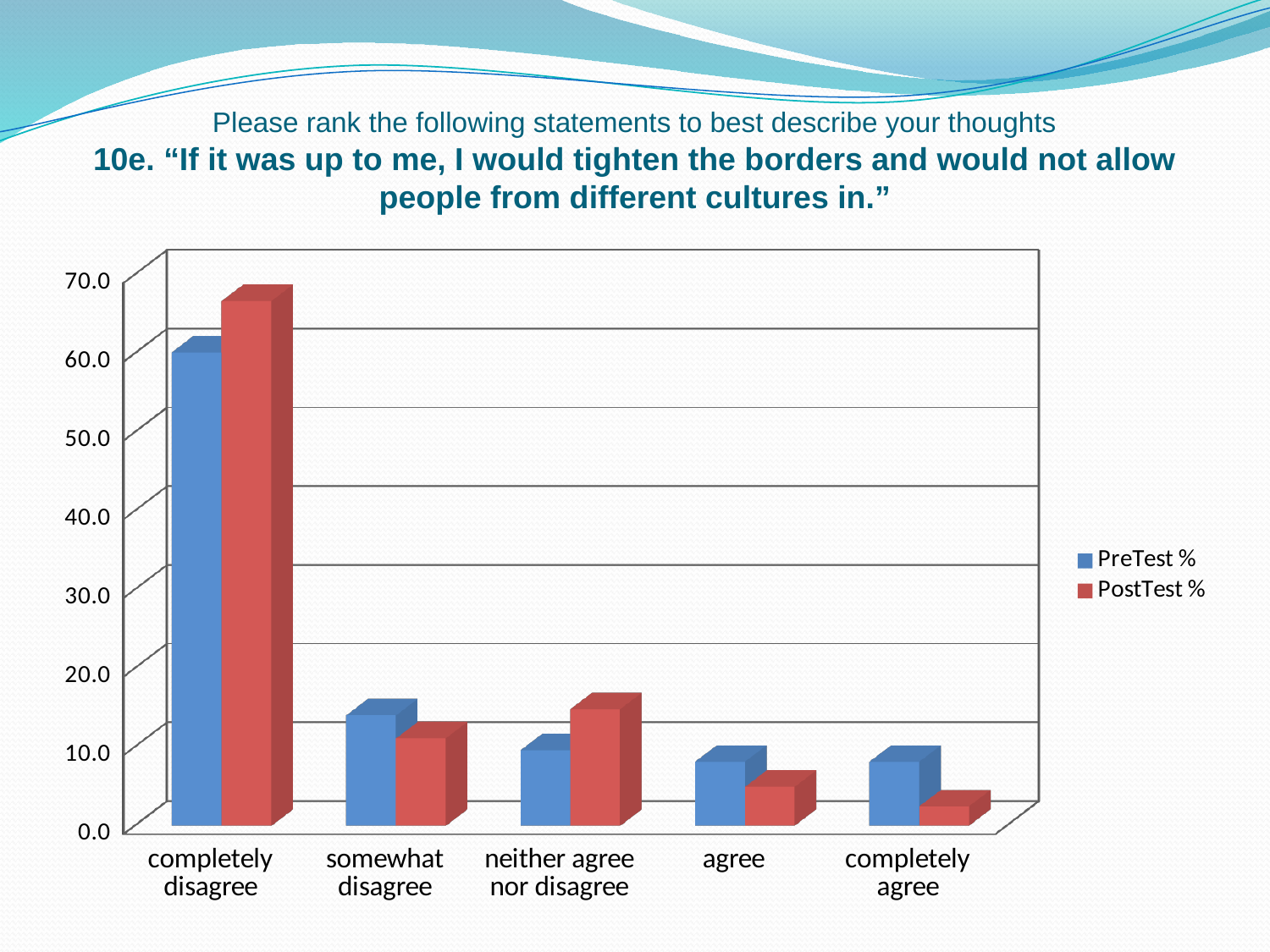
Is the PreTest % value for 'completely disagree' greater or less than 50.0? greater For 'completely disagree', which is larger: the PreTest % or the PostTest % value? PostTest % Is the PostTest % value for 'neither agree nor disagree' greater or less than 10.0? greater Which category has the lowest PostTest % value? completely agree What kind of chart is shown on the slide? bar chart Is the PostTest % value for 'agree' greater or less than 10.0? less How many series does the legend list? 2 Which category has the highest PreTest % value? completely disagree For 'completely agree', which is larger: the PreTest % or the PostTest % value? PreTest % How many response categories are shown on the x axis? 5 What colour are the PostTest % bars? red